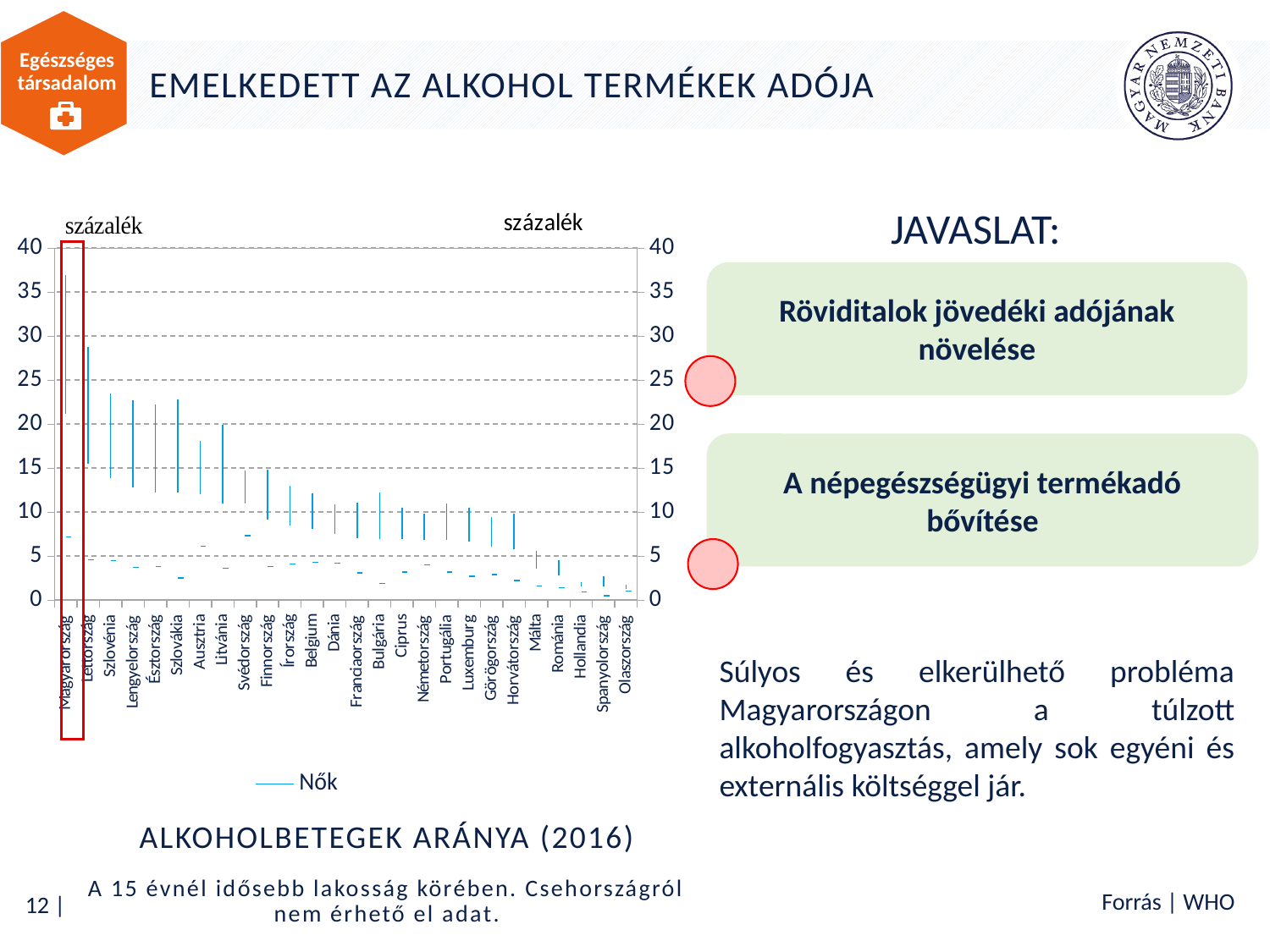
Which has a higher upper value, Magyarország or Lettország? Magyarország Is the upper value for Magyarország greater or less than 35? greater How many series does the chart legend list? 1 Is the upper value for Olaszország greater or less than 5? less Is the upper value for Lettország greater or less than 25? greater What is the title of the chart? ALKOHOLBETEGEK ARÁNYA (2016) Do the values generally rise or fall from left to right along the x axis? fall How many countries are shown on the x axis of the chart? 26 Which has a higher upper value, Szlovákia or Románia? Szlovákia Which country has the highest value on the chart? Magyarország